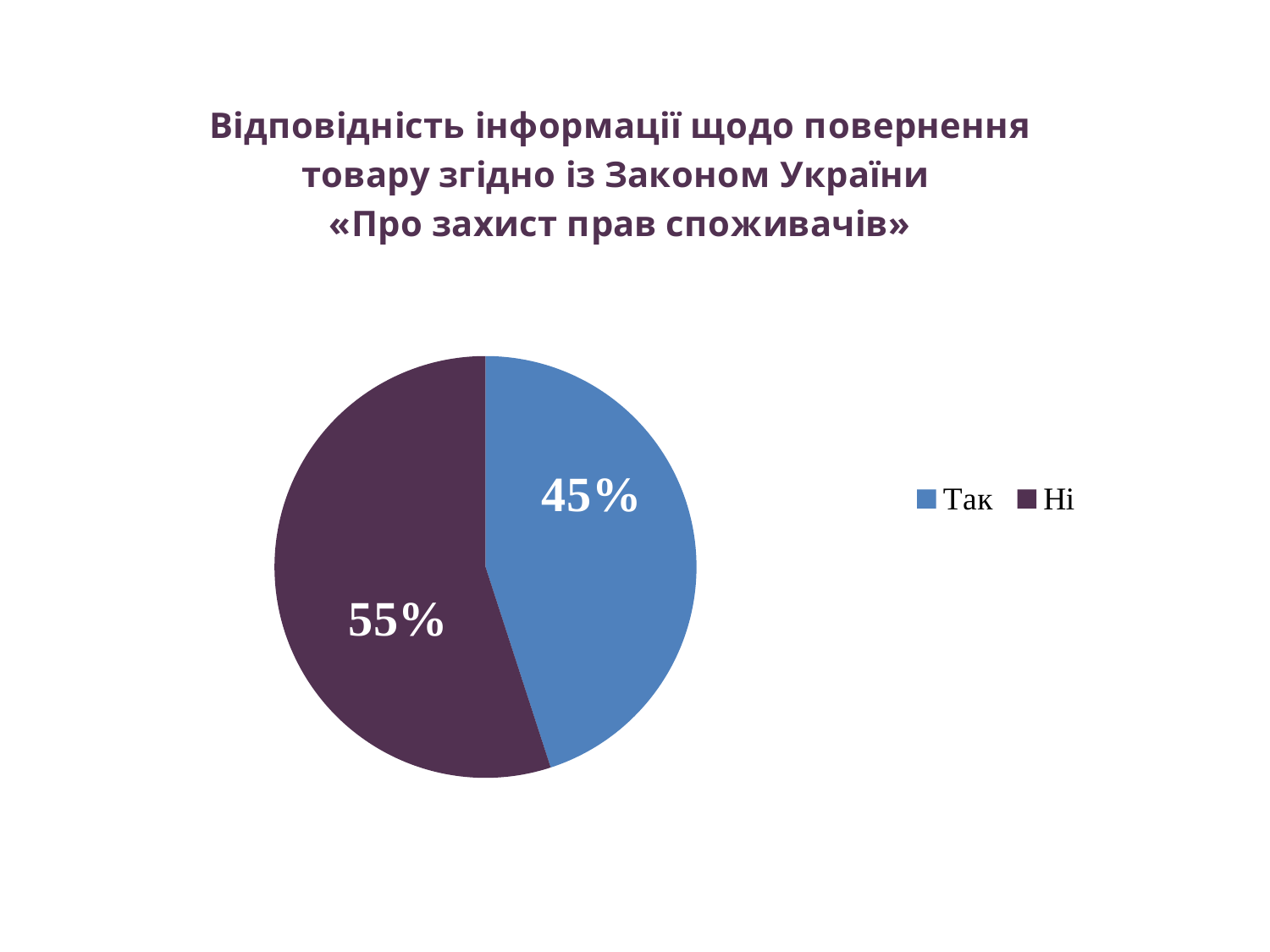
Which category has the largest slice? Ні What share of the pie does "Так" represent? 45% Which category has the smallest slice? Так What is the difference between the "Ні" and "Так" slices? 10% How many slices does the pie chart have? 2 What is the value for "Ні"? 55% What kind of chart is shown on the slide? pie chart What is the value for "Так"? 45% Which legend entry is shown in blue? Так Which is larger, the slice for "Так" or the slice for "Ні"? Ні What colour is the slice for "Ні"? dark purple How many entries does the legend list? 2